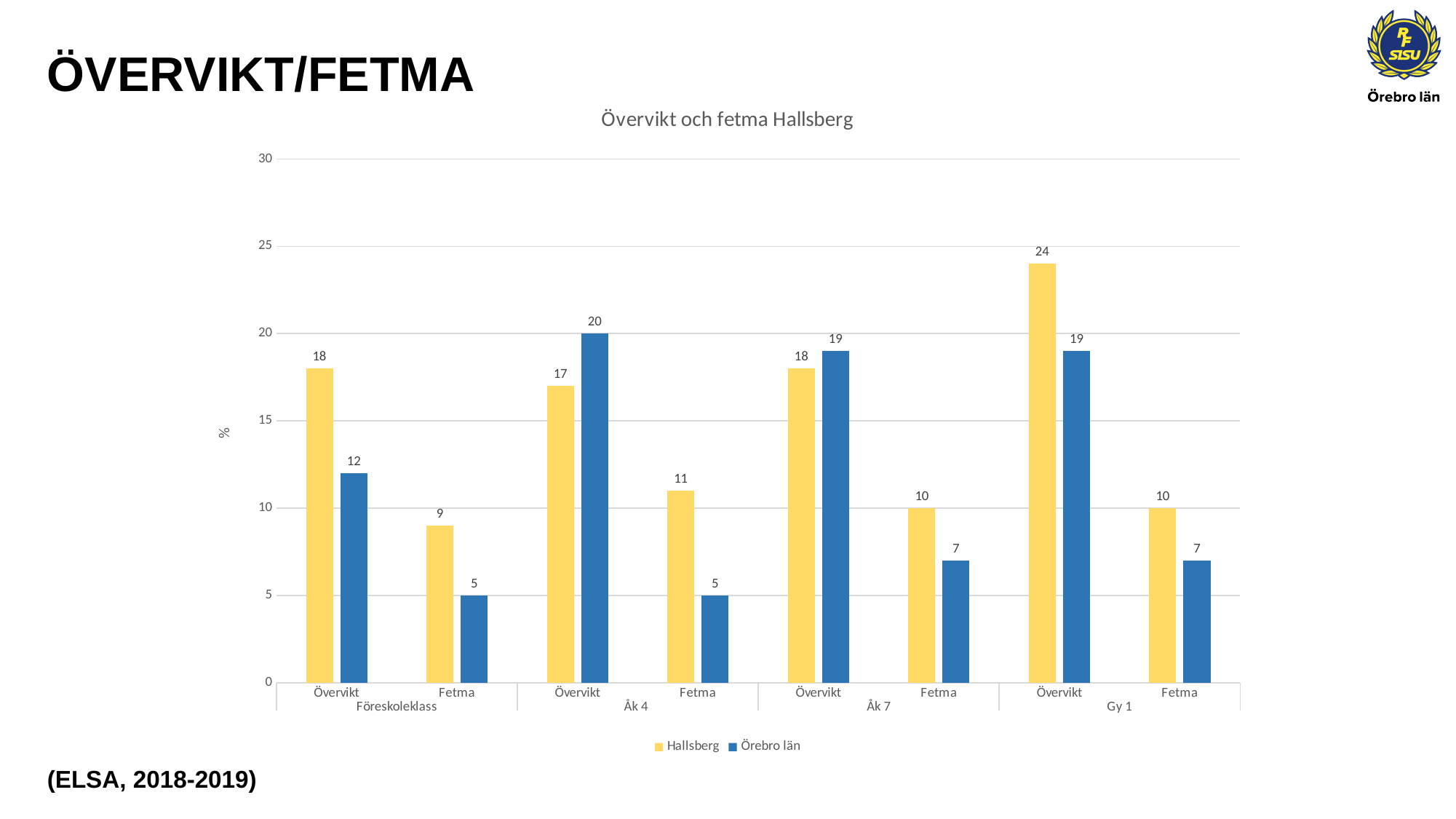
Which category has the highest Hallsberg value? Övervikt, Gy 1 What is the Hallsberg value for Fetma in Åk 7? 10 Which category has the lowest Hallsberg value? Fetma, Föreskoleklass What is the Örebro län value for Övervikt in Åk 4? 20 What is the Örebro län value for Fetma in Föreskoleklass? 5 What is the Hallsberg value for Övervikt in Gy 1? 24 Which is larger for Övervikt in Åk 4: Hallsberg or Örebro län? Örebro län Which colour represents Hallsberg in the chart? Yellow What is the difference between the Hallsberg and Örebro län values for Övervikt in Föreskoleklass? 6 What is the title of the chart? Övervikt och fetma Hallsberg What kind of chart is shown? Bar chart How many series does the legend list? 2